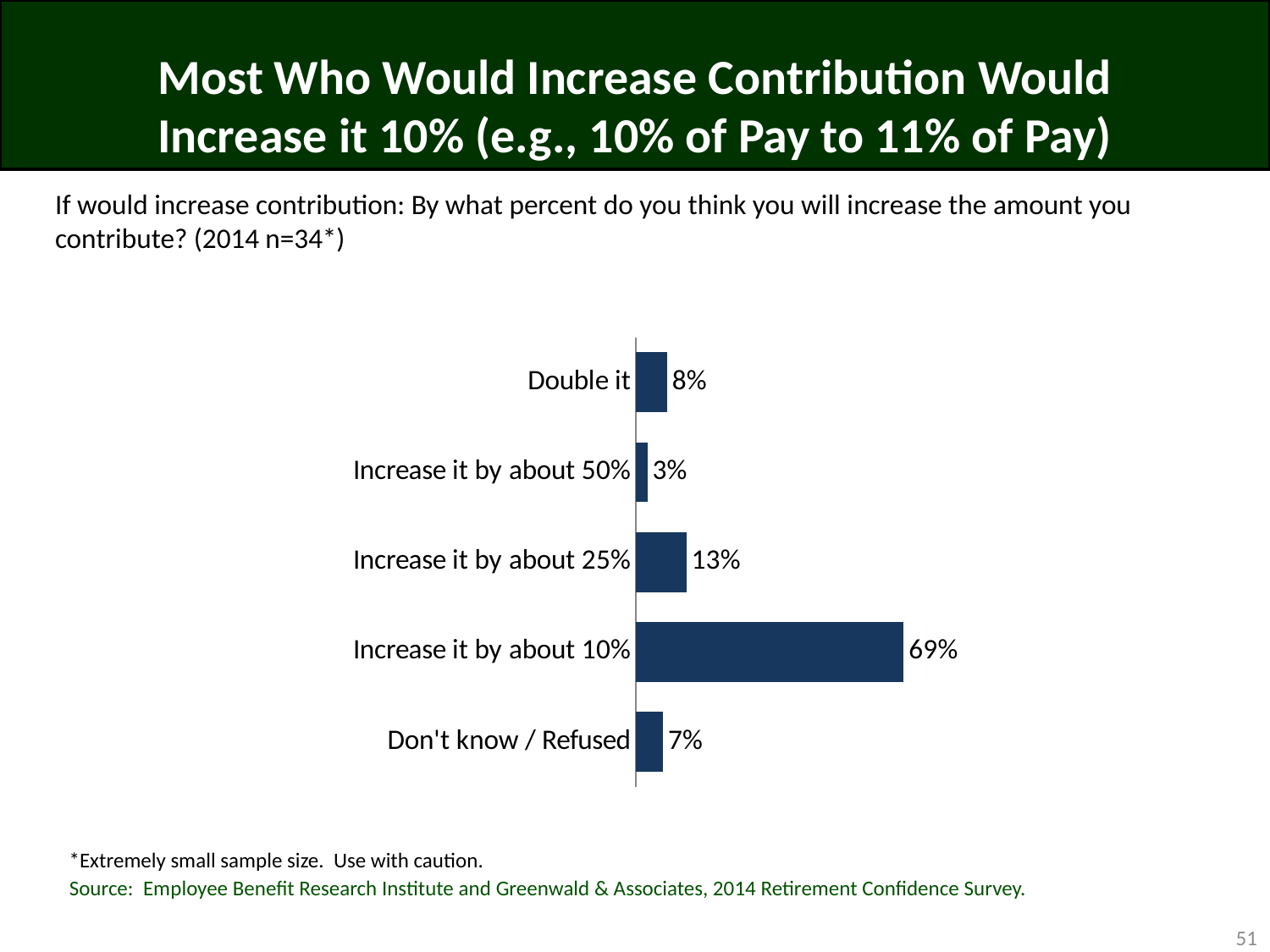
What type of chart is shown on the slide? Bar chart What is the difference in percentage points between 'Increase it by about 10%' and 'Increase it by about 25%'? 56 What percentage of respondents said they would increase their contribution by about 25%? 13% What is the difference in percentage points between 'Double it' and 'Don't know / Refused'? 1 What percentage of respondents said they would double their contribution? 8% Which response category has the highest percentage? Increase it by about 10% What is the sample size noted for the 2014 survey question shown on the slide? n=34 How many response categories are shown in the chart? 5 Which is larger: the percentage for 'Double it' or for 'Increase it by about 50%'? Double it Which response category has the lowest percentage? Increase it by about 50% What percentage of respondents said they would increase their contribution by about 10%? 69% What percentage of respondents answered Don't know / Refused? 7%